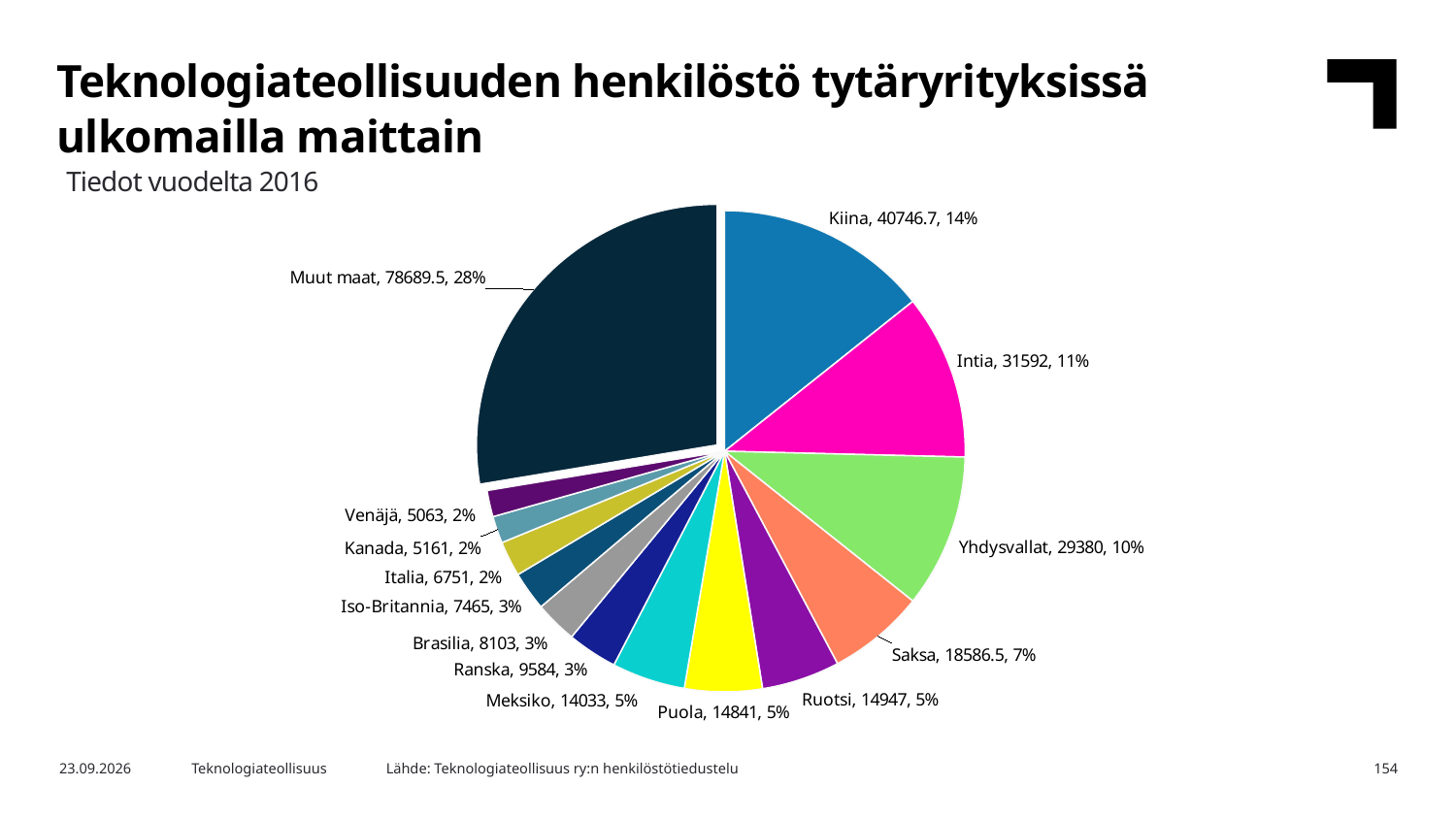
Which is larger, the value for Ruotsi or the value for Puola? Ruotsi What is the value for Kiina? 40746.7 Which year does the data on the slide come from? 2016 What share of the pie does Intia represent? 11% What is the value for Meksiko? 14033 What is the value for Saksa? 18586.5 Which slice has the largest value? Muut maat Which country slice has the smallest value? Venäjä What type of chart is shown on the slide? pie chart What is the difference between the values for Intia and Yhdysvallat? 2212 How many slices does the pie chart have? 14 What share of the pie does Muut maat represent? 28%